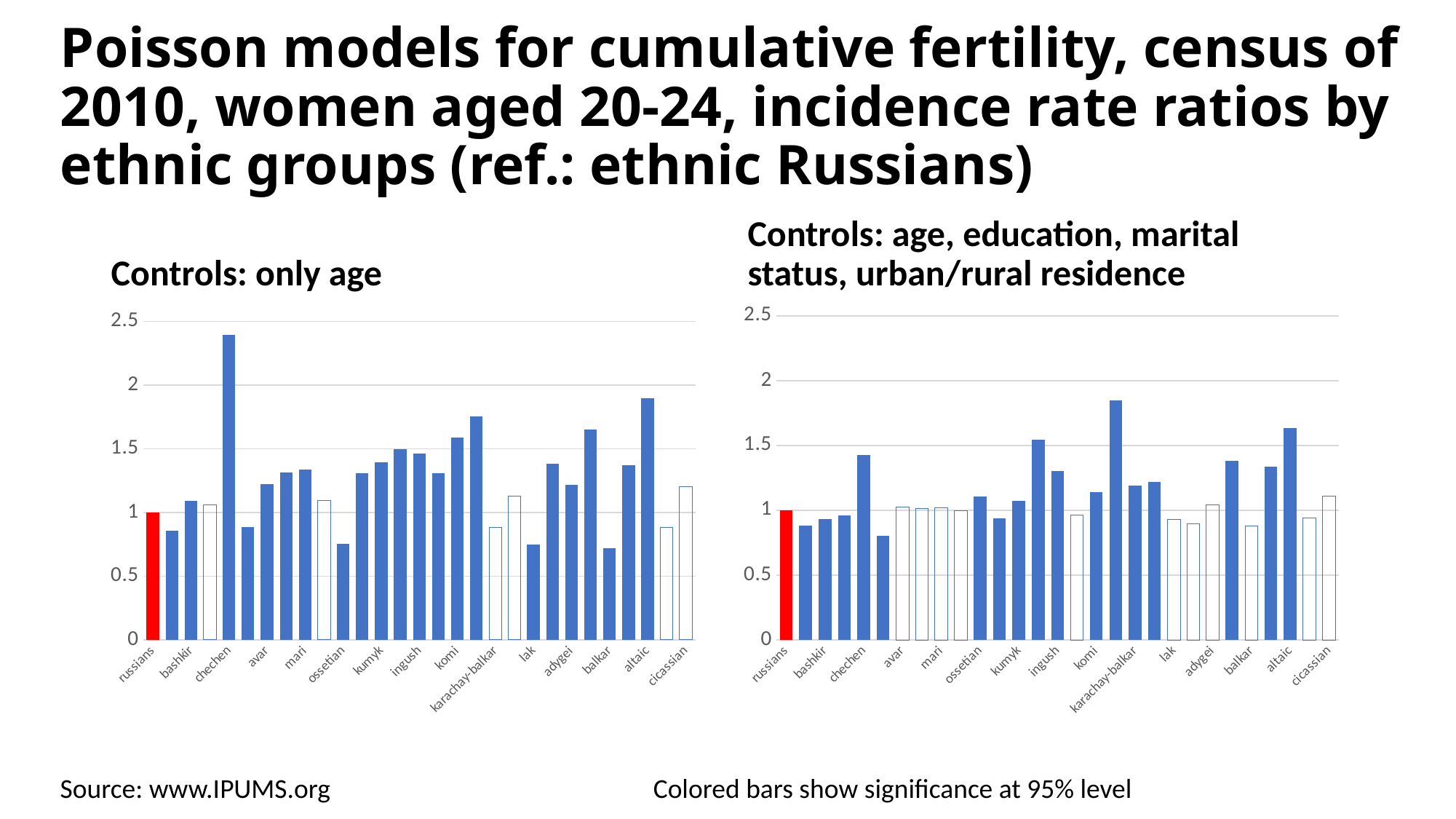
In the 'Controls: only age' chart, which is larger, the value for komi or the value for ossetian? komi In the 'Controls: age, education, marital status, urban/rural residence' chart, which is larger, the value for chechen or the value for altaic? altaic In the 'Controls: only age' chart, is the value for altaic greater or less than 1.5? greater In the 'Controls: age, education, marital status, urban/rural residence' chart, is the value for balkar greater or less than 1? less In the 'Controls: only age' chart, which ethnic group is shown with a red bar? russians In the 'Controls: age, education, marital status, urban/rural residence' chart, is the value for altaic greater or less than 1.5? greater What type of chart is used in the 'Controls: only age' chart? bar chart In the 'Controls: only age' chart, which ethnic group has the highest bar? chechen In the 'Controls: only age' chart, what is the value for russians? 1